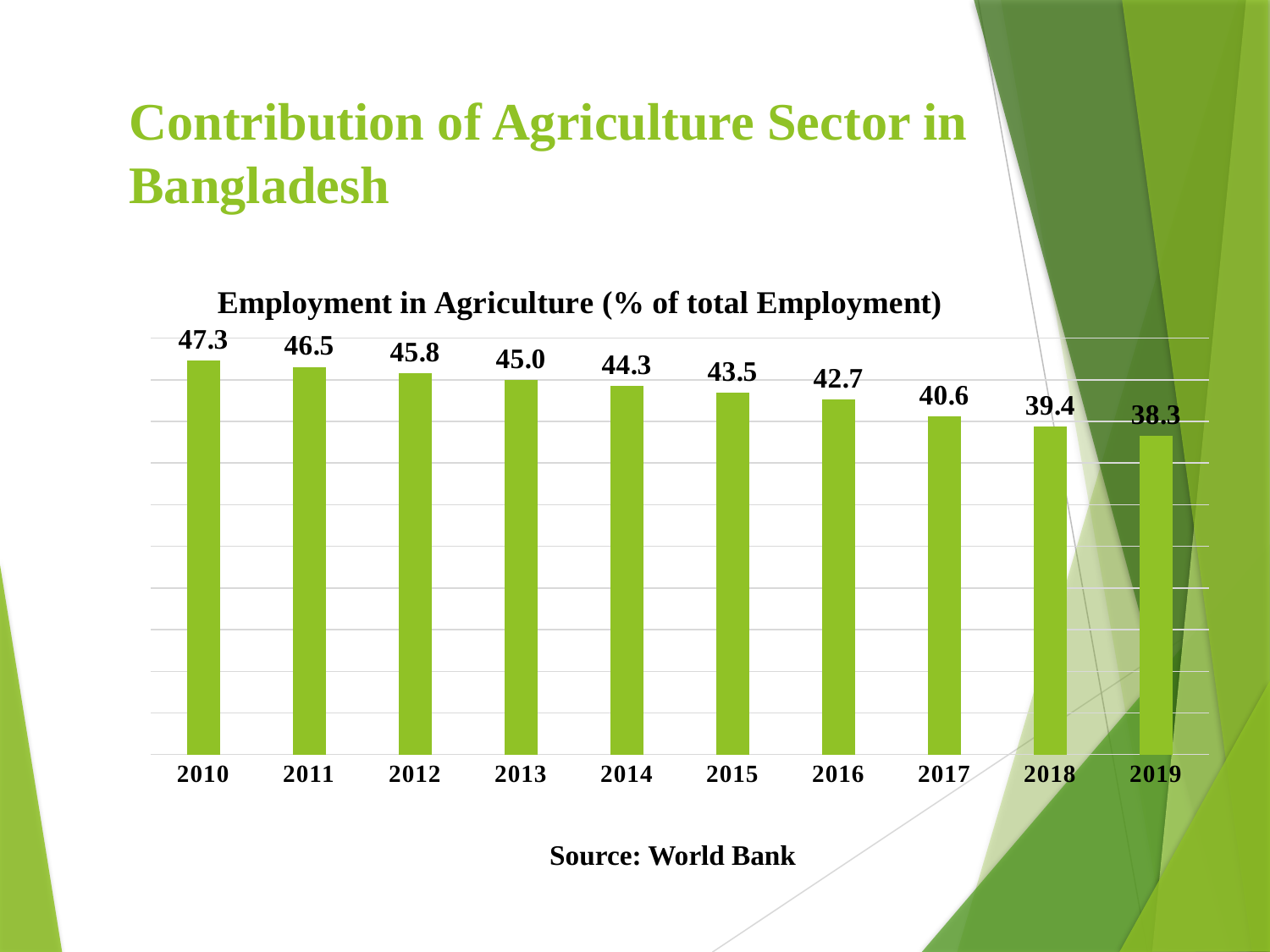
What kind of chart is shown? Bar chart What is the value for 2015? 43.5 What is the difference between the values for 2016 and 2017? 2.1 Which year has the lowest value? 2019 Do the values rise or fall from 2010 to 2019? Fall What is the difference between the values for 2010 and 2019? 9.0 Which year has the highest value? 2010 What is the value for 2019? 38.3 What is the value for 2017? 40.6 Which is larger, the value for 2013 or the value for 2018? 2013 How many years are shown on the chart? 10 What is the value for 2010? 47.3